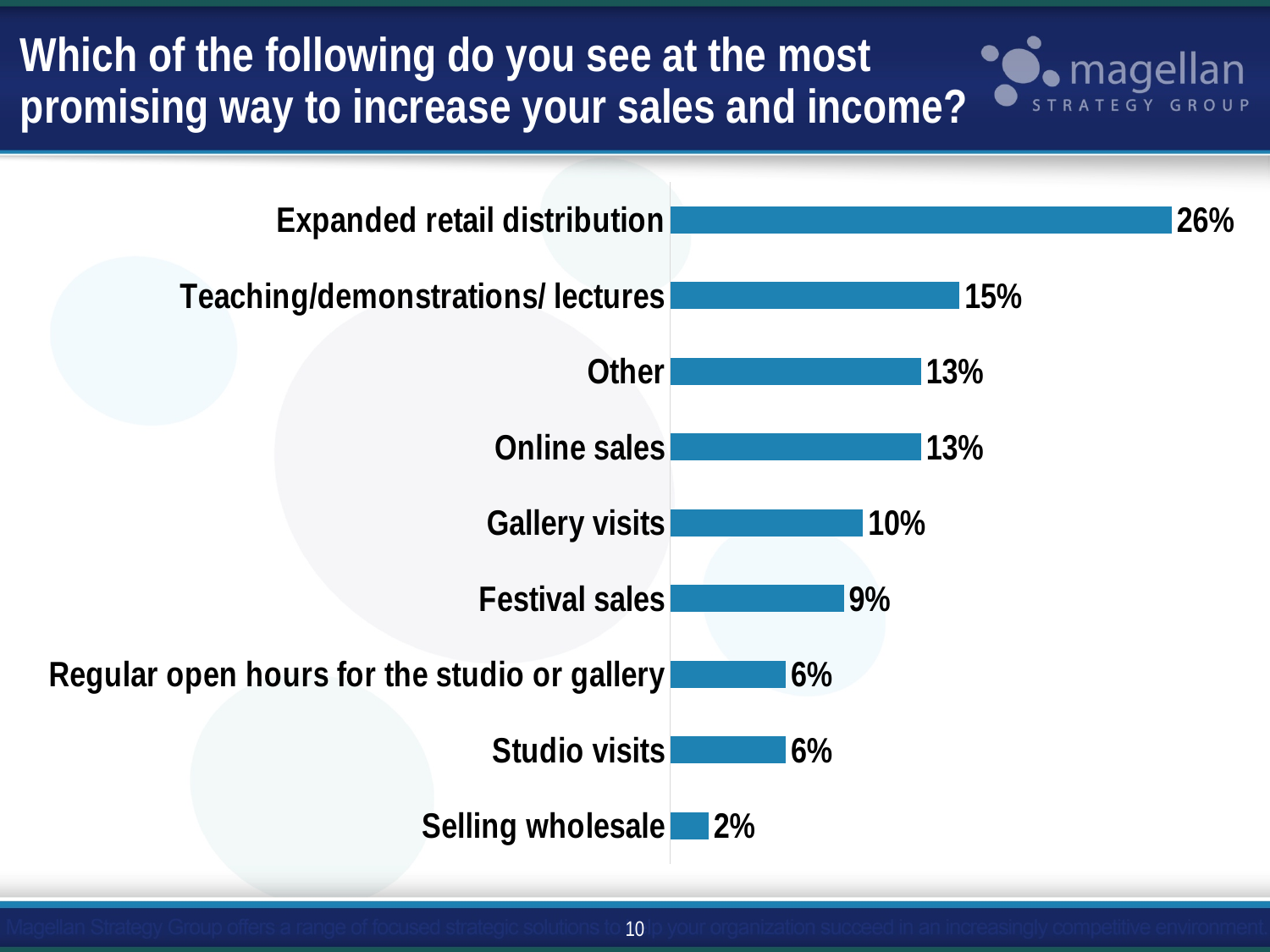
What colour are the bars in the chart? Blue What is the difference between Online sales and Selling wholesale? 11% What is the value shown for Festival sales? 9% What percentage of respondents chose Expanded retail distribution? 26% What kind of chart is shown on the slide? Bar chart How many categories are shown in the chart? 9 Which category has the highest value? Expanded retail distribution What is the value shown for Gallery visits? 10% Which is larger, Teaching/demonstrations/ lectures or Gallery visits? Teaching/demonstrations/ lectures Which category has the lowest value? Selling wholesale What is the difference between Expanded retail distribution and Teaching/demonstrations/ lectures? 11% What value is shown for Studio visits? 6%